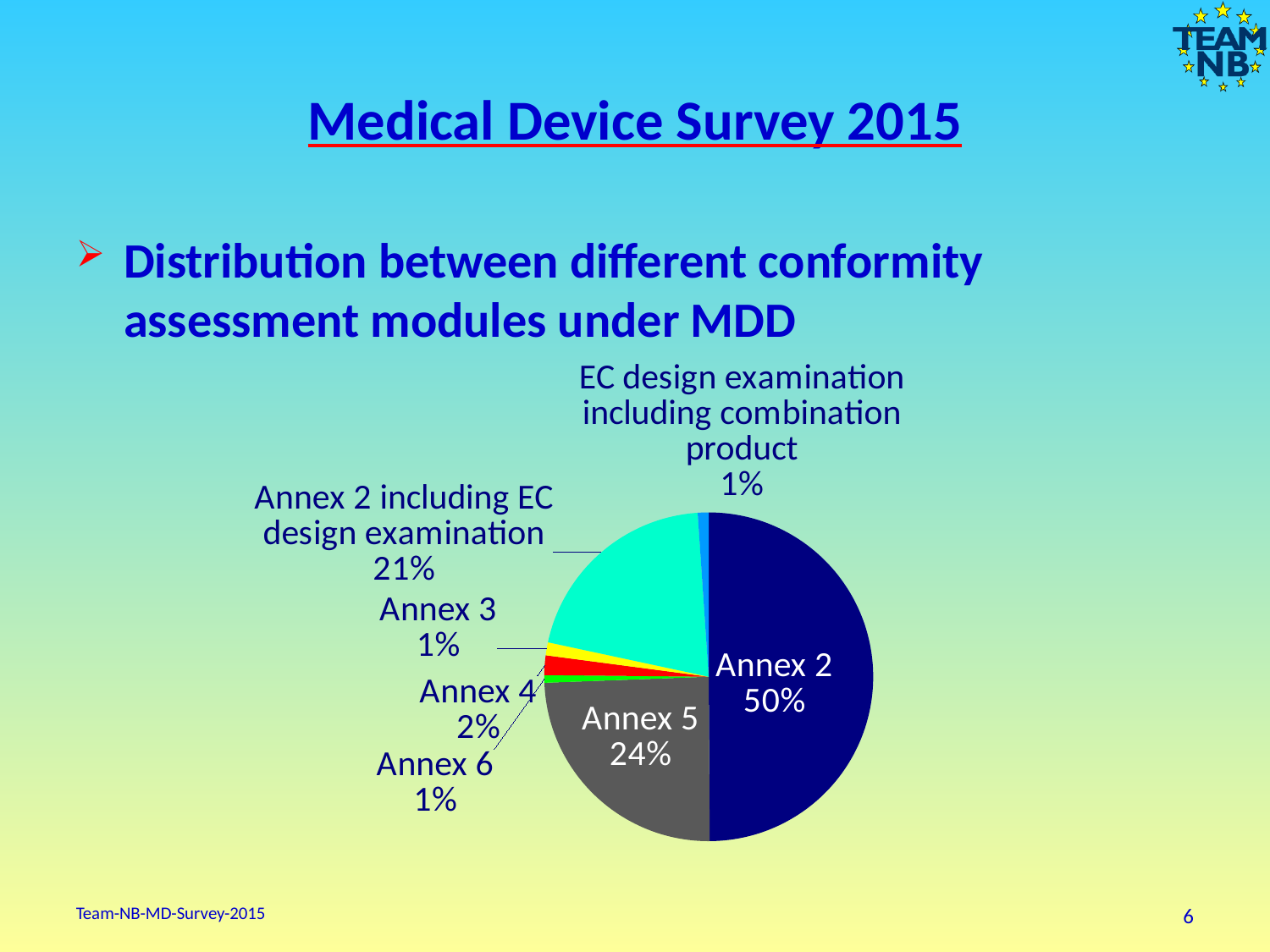
What colour is the Annex 2 slice of the pie? dark blue How many slices does the pie chart have? 7 What is the value shown for Annex 5? 24% What is the value shown for Annex 4? 2% What share of the pie does Annex 2 account for? 50% What is the value shown for Annex 2 including EC design examination? 21% What kind of chart is shown on the slide? pie chart What is the difference between the Annex 2 share and the Annex 5 share? 26% What is the difference between the Annex 4 share and the Annex 3 share? 1% Which is larger, the share for Annex 5 or the share for Annex 2 including EC design examination? Annex 5 Which slice of the pie is the largest? Annex 2 What is the value shown for EC design examination including combination product? 1%